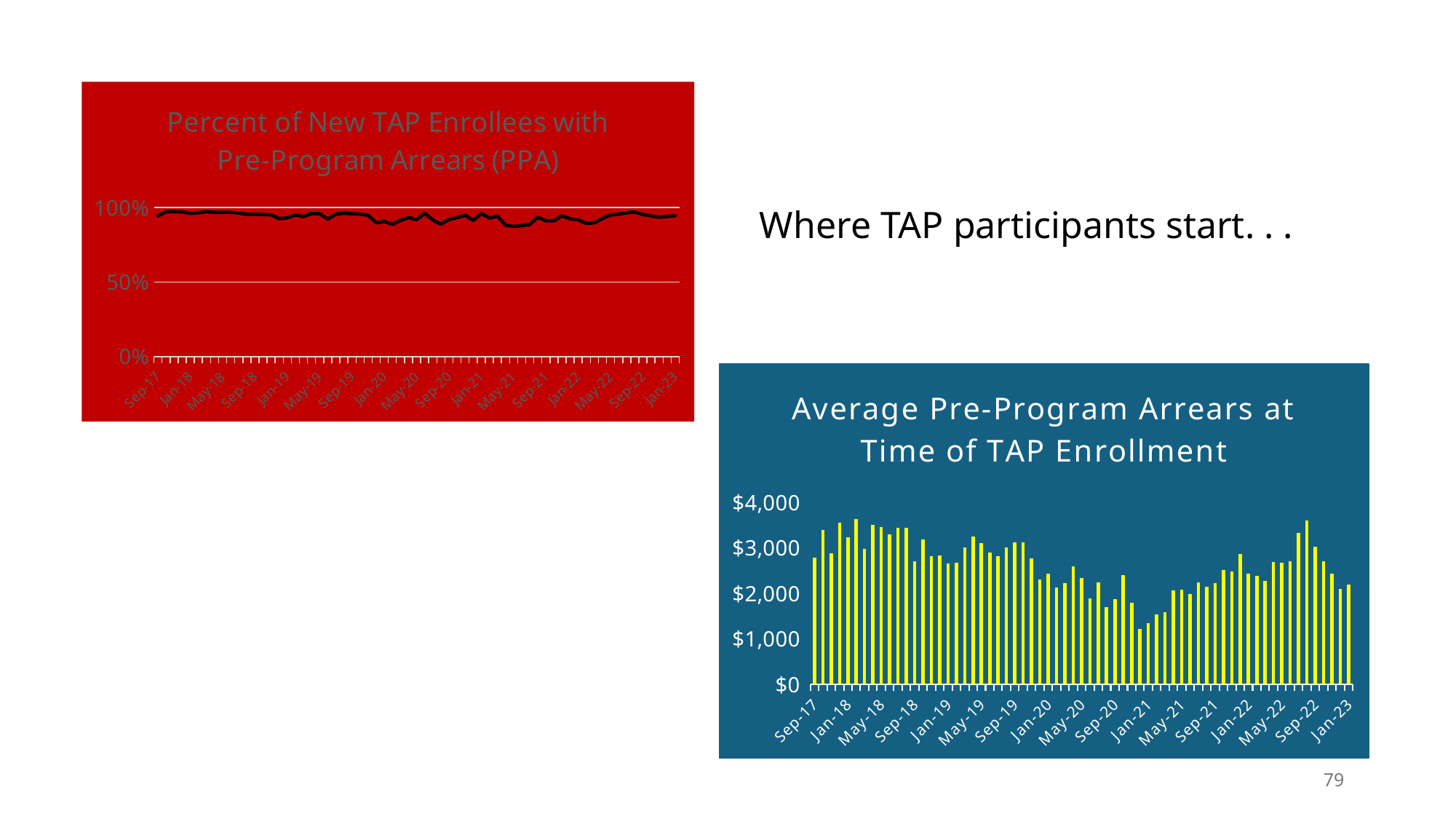
What is the title of the chart on the red background? Percent of New TAP Enrollees with Pre-Program Arrears (PPA) In the 'Average Pre-Program Arrears at Time of TAP Enrollment' chart, which is larger, the value for Jan-18 or the value for Jan-21? Jan-18 In the 'Average Pre-Program Arrears at Time of TAP Enrollment' chart, is the value for Jan-18 greater or less than $3,000? greater In the 'Average Pre-Program Arrears at Time of TAP Enrollment' chart, which month has the lowest bar? Dec-20 In the 'Average Pre-Program Arrears at Time of TAP Enrollment' chart, is the value for Sep-17 greater or less than $2,000? greater In the 'Percent of New TAP Enrollees with Pre-Program Arrears (PPA)' chart, is the value for Jan-23 greater or less than 50%? greater What colour are the bars in the 'Average Pre-Program Arrears at Time of TAP Enrollment' chart? yellow In the 'Percent of New TAP Enrollees with Pre-Program Arrears (PPA)' chart, does the line stay close to 100% or drop toward 0% over the period? stays close to 100% What kind of chart is the 'Average Pre-Program Arrears at Time of TAP Enrollment' chart? bar chart What kind of chart is the 'Percent of New TAP Enrollees with Pre-Program Arrears (PPA)' chart? line chart